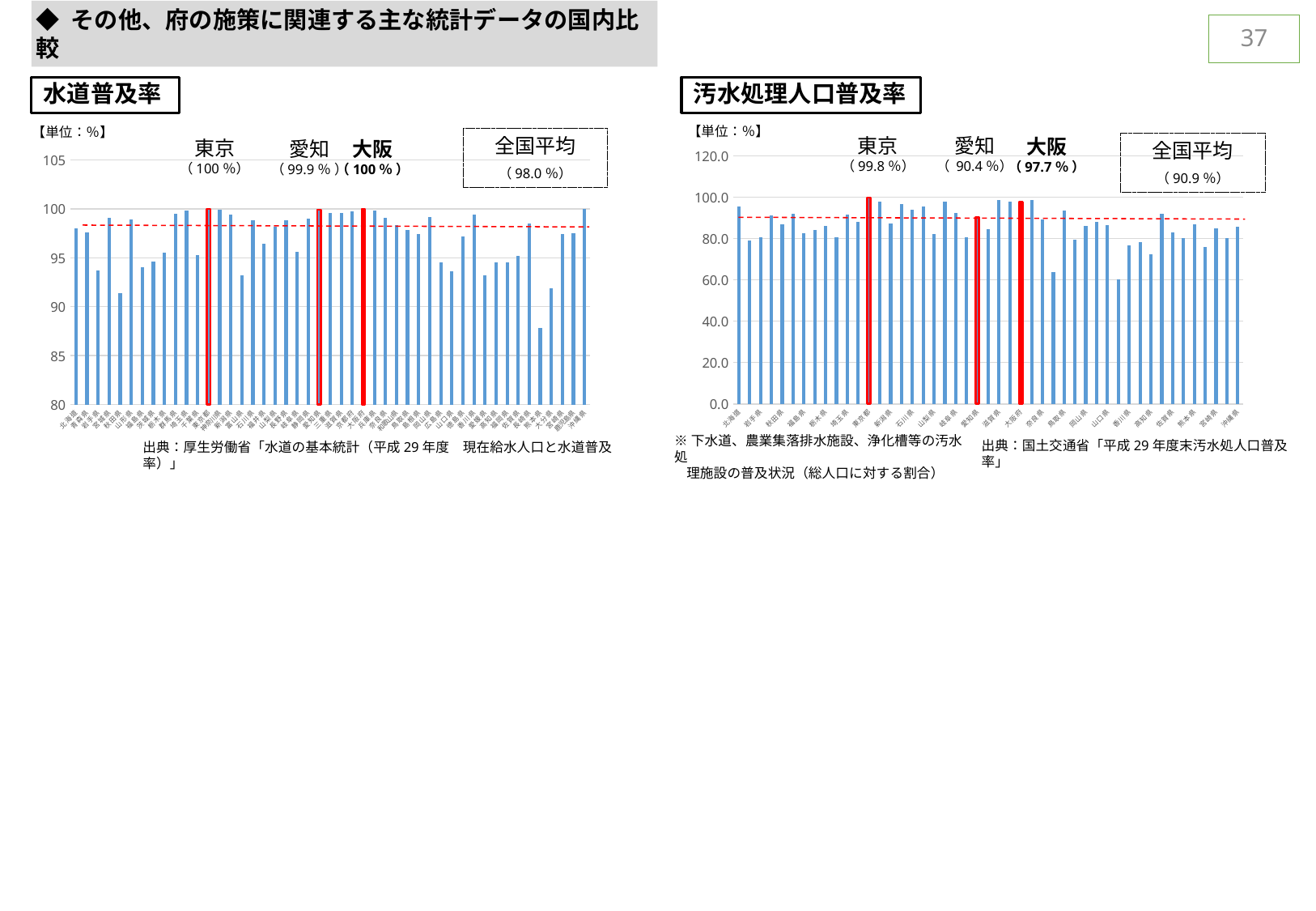
In the 水道普及率 chart, how much higher is 大阪 than the 全国平均? 2.0 % In the 水道普及率 chart, what is the value for 愛知? 99.9 % In the 汚水処理人口普及率 chart, how much higher is 大阪 than the 全国平均? 6.8 % What kind of chart is the 水道普及率 chart? bar chart In the 汚水処理人口普及率 chart, is the value for 愛知 greater or less than 80.0? greater In the 汚水処理人口普及率 chart, what is the value for 大阪? 97.7 % In the 水道普及率 chart, what is the value for 大阪? 100 % What unit is used for the values in the 汚水処理人口普及率 chart? % In the 水道普及率 chart, what is the 全国平均 (national average) value? 98.0 % In the 汚水処理人口普及率 chart, which is larger, the value for 東京 or the value for 愛知? 東京 In the 汚水処理人口普及率 chart, what is the 全国平均 (national average) value? 90.9 % In the 汚水処理人口普及率 chart, what is the value for 東京? 99.8 %